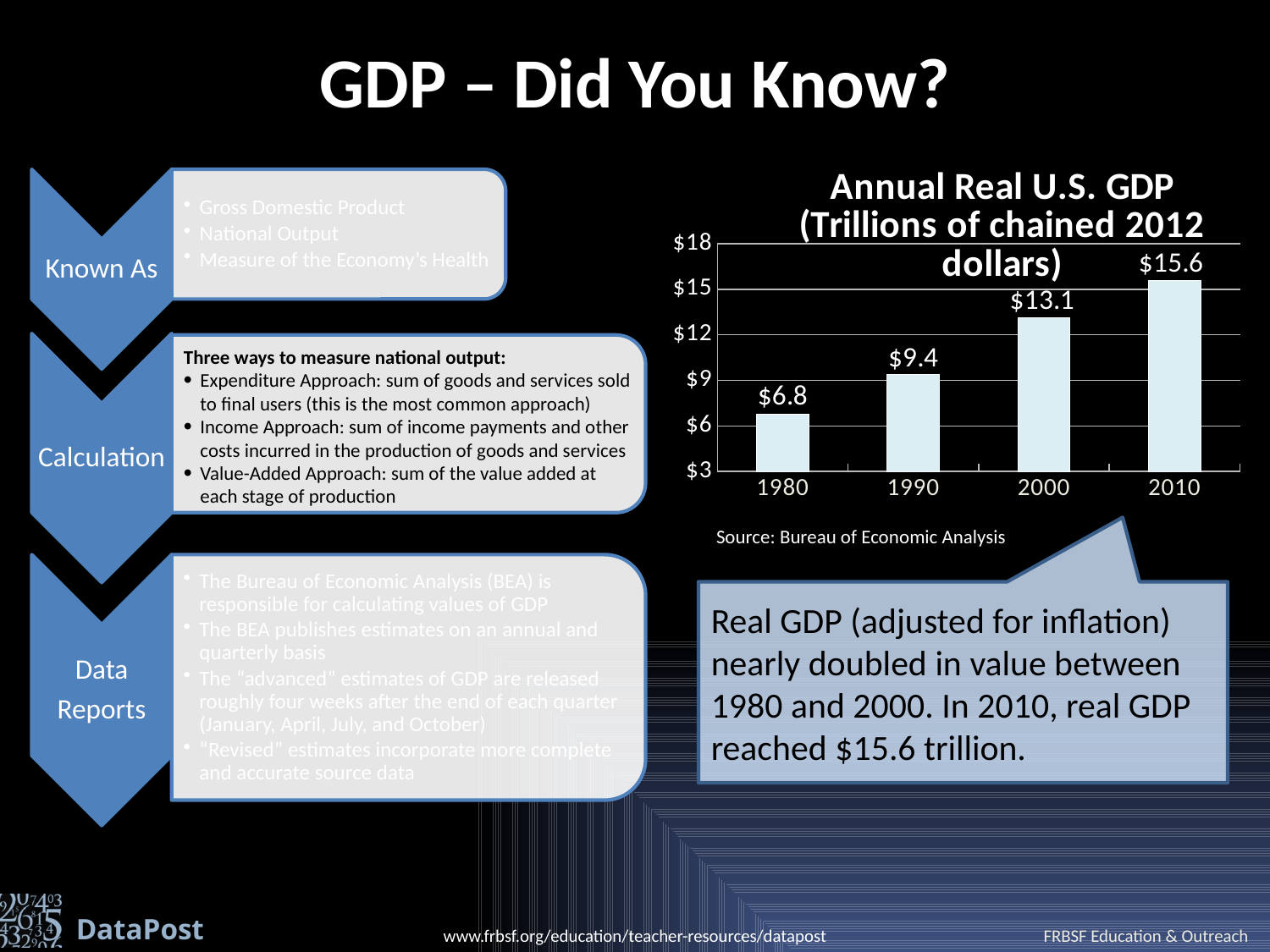
Which year has the highest real GDP in the chart? 2010 What is the difference between the 2010 and 1980 values in the chart? $8.8 What is the value for 2000 in the Annual Real U.S. GDP chart? $13.1 Which is larger in the chart, the value for 1990 or the value for 2000? 2000 What is the value for 1990 in the Annual Real U.S. GDP chart? $9.4 How many years are shown on the x axis of the chart? 4 Which year has the lowest real GDP in the chart? 1980 What source is cited below the chart? Bureau of Economic Analysis Do the values in the chart rise or fall from 1980 to 2010? rise Is the value for 2010 in the chart greater or less than $15? greater What kind of chart is used to show Annual Real U.S. GDP? bar chart What is the value for 1980 in the Annual Real U.S. GDP chart? $6.8